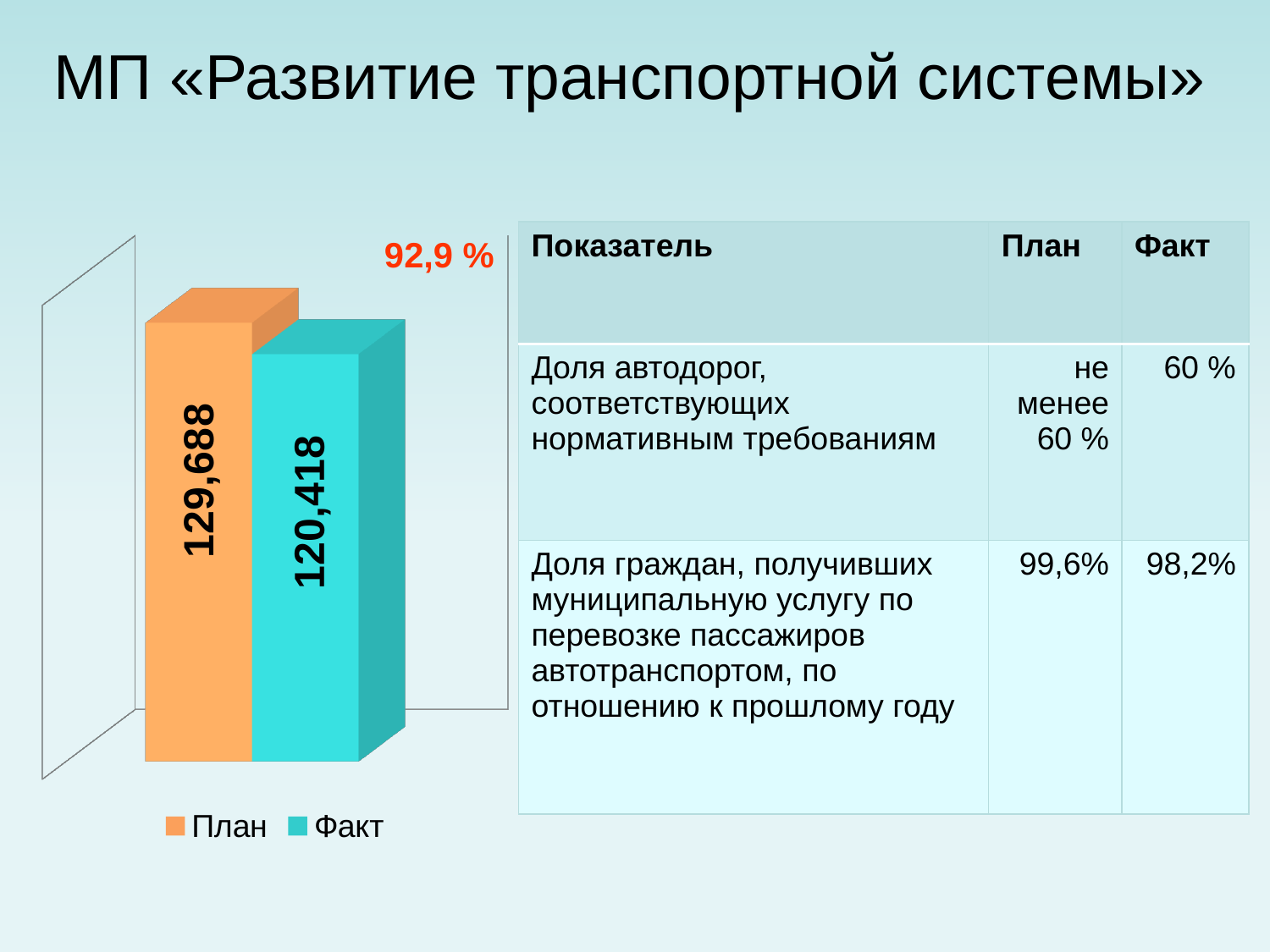
What is the value of the План bar in the chart? 129,688 Which bar in the chart is the highest? План What kind of chart is shown on the slide? Bar chart What is the value of the Факт bar in the chart? 120,418 What colour is the Факт bar in the chart? Turquoise Which series has the higher bar in the chart, План or Факт? План How many series does the chart legend list? 2 What is the difference between the План and Факт values in the chart? 9,270 What percentage is printed in red above the chart? 92,9 % Which bar in the chart is the lowest? Факт How many bars are plotted in the chart? 2